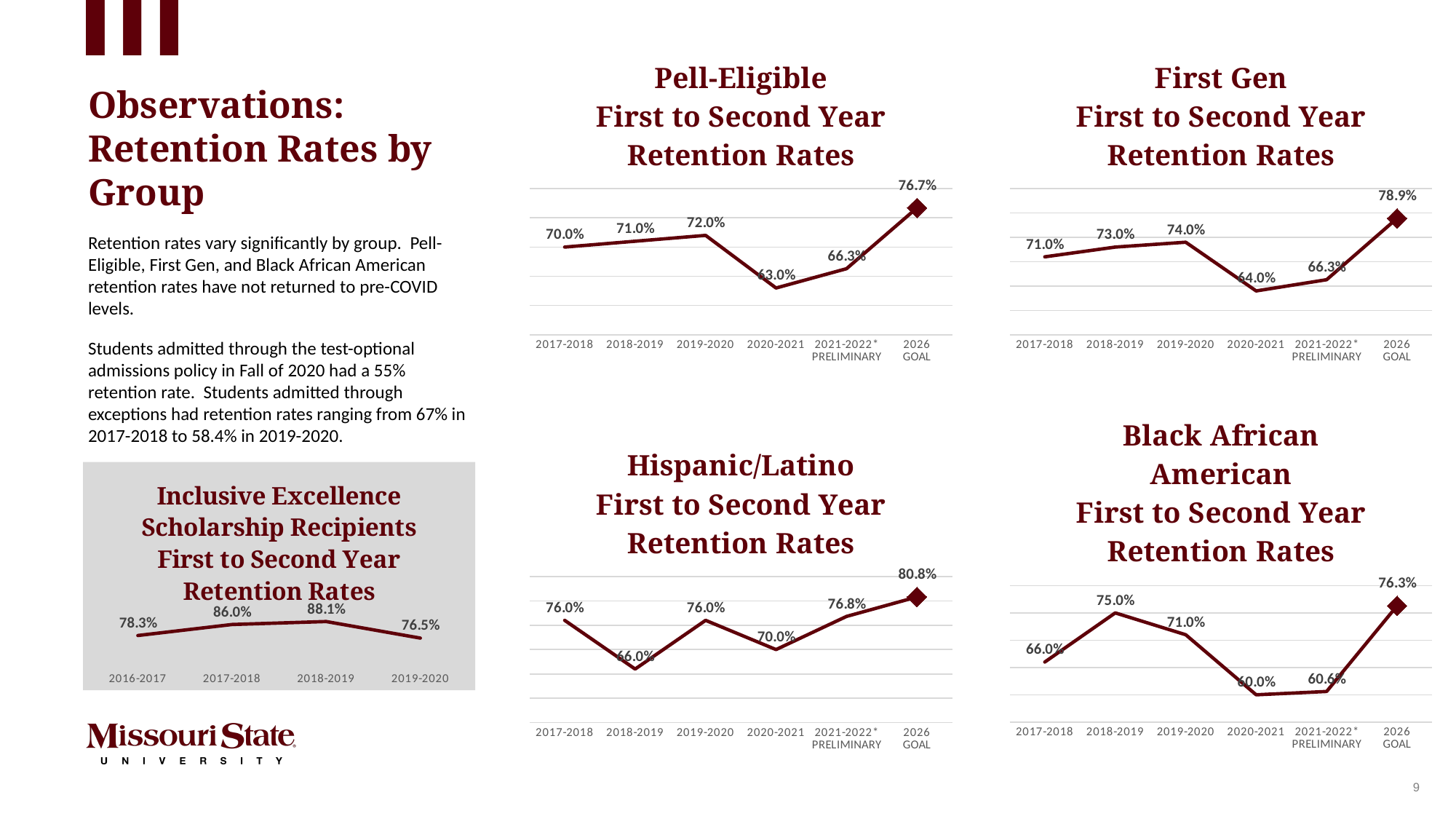
How many data points are plotted in the Inclusive Excellence Scholarship Recipients chart? 4 In the Pell-Eligible First to Second Year Retention Rates chart, what is the retention rate for 2020-2021? 63.0% In the Black African American First to Second Year Retention Rates chart, which year has the highest retention rate among the actual (non-goal) years? 2018-2019 In the First Gen First to Second Year Retention Rates chart, what is the 2026 goal value? 78.9% In the Black African American chart, what is the difference between the 2026 goal and the 2021-2022* Preliminary rate? 15.7% How many charts on the slide show a 2026 Goal data point? 4 In the Hispanic/Latino First to Second Year Retention Rates chart, which year has the lowest retention rate? 2018-2019 In the Inclusive Excellence Scholarship Recipients chart, what is the retention rate for 2018-2019? 88.1% In the Inclusive Excellence Scholarship Recipients chart, does the retention rate rise or fall from 2018-2019 to 2019-2020? Fall What type of chart is the Hispanic/Latino First to Second Year Retention Rates chart? Line chart In the First Gen chart, which is larger: the 2018-2019 rate or the 2021-2022* Preliminary rate? 2018-2019 In the Pell-Eligible chart, what is the difference between the 2019-2020 rate and the 2020-2021 rate? 9.0%